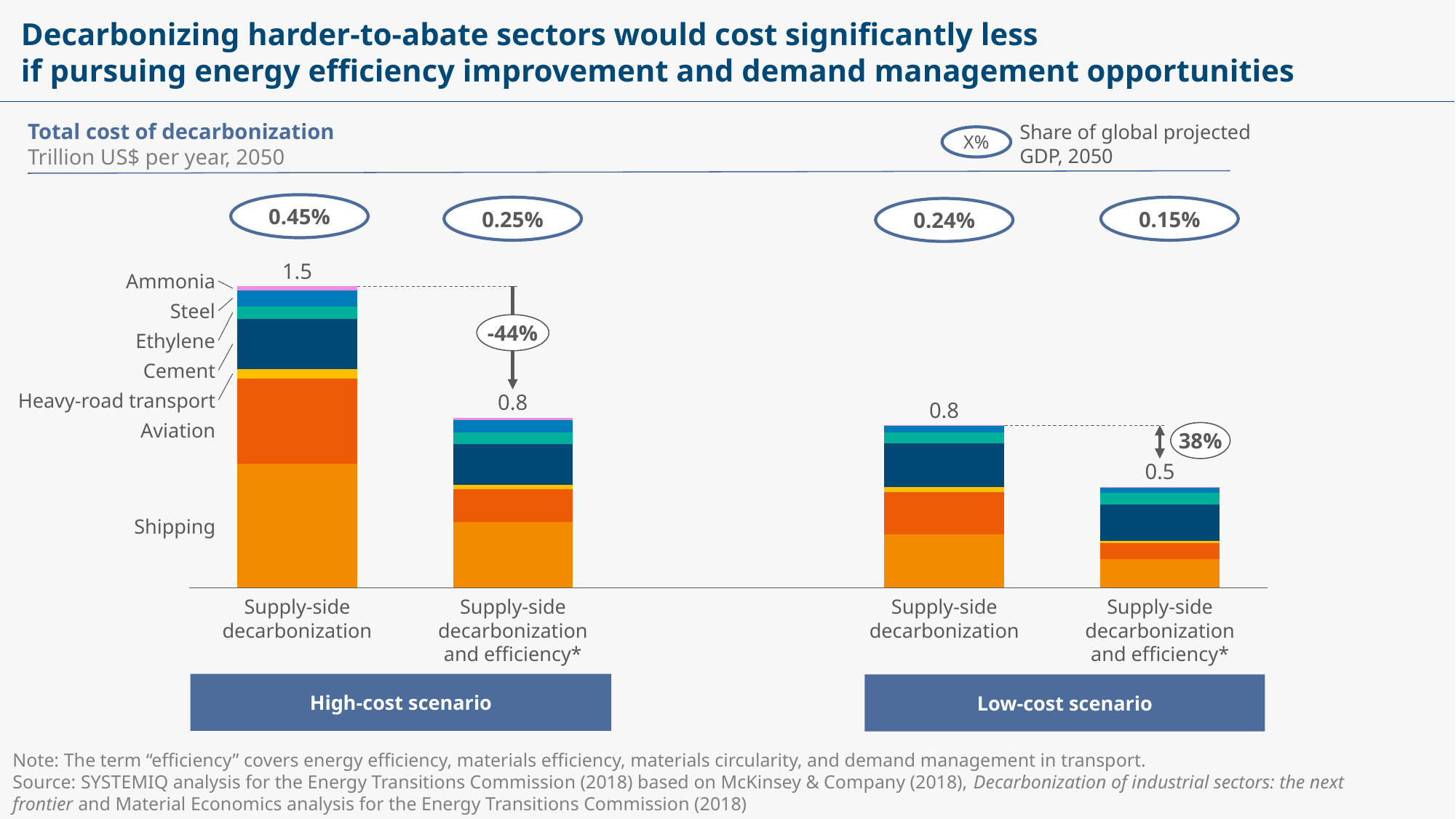
What is the total cost of decarbonization for supply-side decarbonization and efficiency in the low-cost scenario? 0.5 What kind of chart is shown on the slide? Stacked bar chart How many sectors are stacked in each bar? 7 What share of global projected GDP in 2050 does supply-side decarbonization and efficiency represent in the low-cost scenario? 0.15% What is the total cost of decarbonization for supply-side decarbonization and efficiency in the high-cost scenario? 0.8 Which bar has the lowest total cost of decarbonization? Supply-side decarbonization and efficiency (low-cost scenario) What share of global projected GDP in 2050 does supply-side decarbonization represent in the high-cost scenario? 0.45% Which is larger: the total cost for supply-side decarbonization in the low-cost scenario or for supply-side decarbonization and efficiency in the low-cost scenario? Supply-side decarbonization What is the difference in total cost between supply-side decarbonization and supply-side decarbonization and efficiency in the high-cost scenario? 0.7 Which bar has the highest total cost of decarbonization? Supply-side decarbonization (high-cost scenario) What percentage reduction is shown between the two bars in the high-cost scenario? -44% What is the total cost of decarbonization for supply-side decarbonization in the high-cost scenario? 1.5